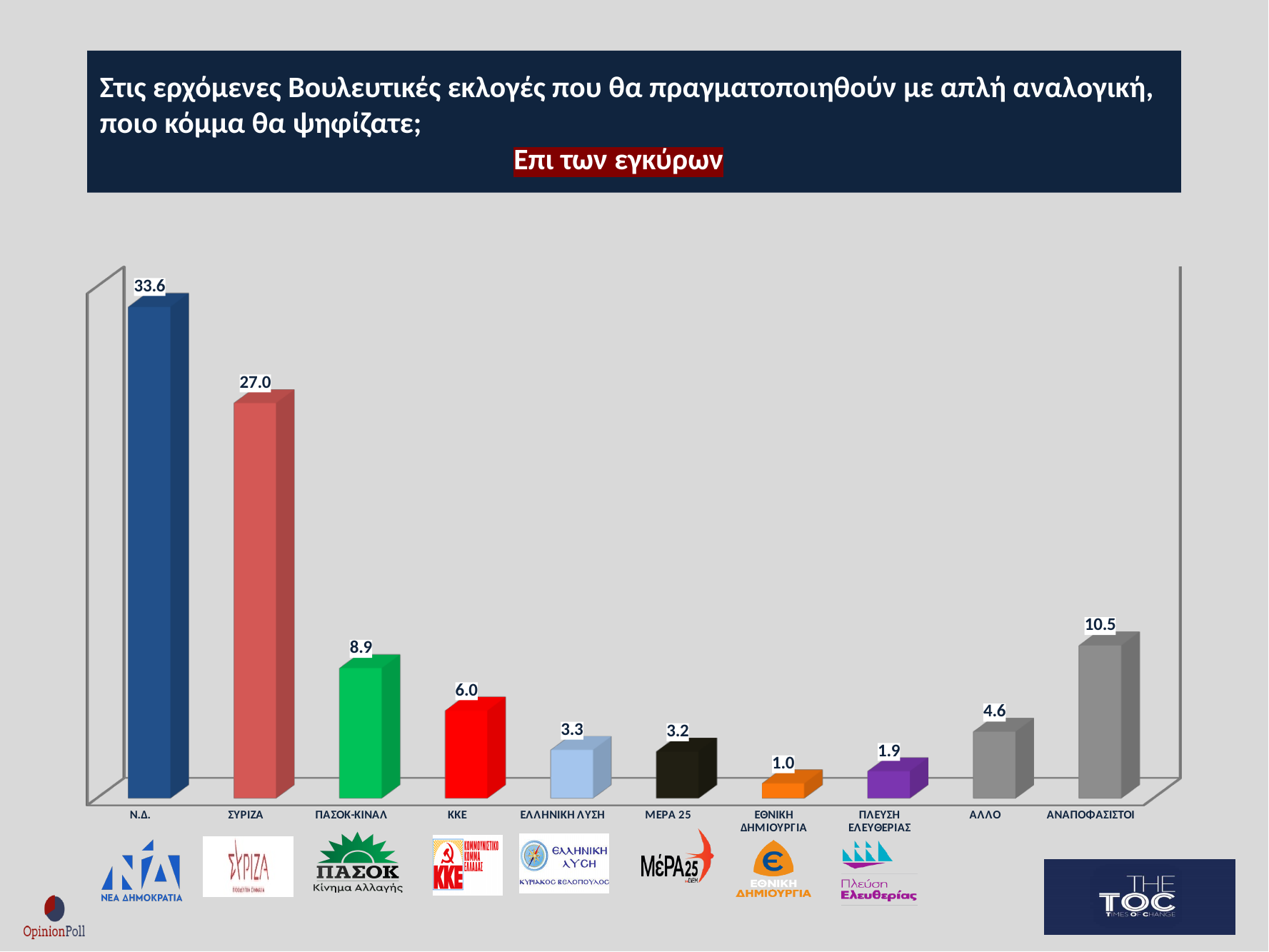
What is the value for ΑΝΑΠΟΦΑΣΙΣΤΟΙ? 10.5 What is the difference between the values for Ν.Δ. and ΣΥΡΙΖΑ? 6.6 What kind of chart is shown on the slide? bar chart What is the difference between the values for ΠΑΣΟΚ-ΚΙΝΑΛ and ΚΚΕ? 2.9 What colour is the bar for ΠΛΕΥΣΗ ΕΛΕΥΘΕΡΙΑΣ? purple What is the value for Ν.Δ.? 33.6 What is the value for ΠΑΣΟΚ-ΚΙΝΑΛ? 8.9 Which is larger, the value for ΚΚΕ or the value for ΑΛΛΟ? ΚΚΕ How many categories are shown on the chart? 10 What is the value for ΣΥΡΙΖΑ? 27.0 Which category has the lowest value? ΕΘΝΙΚΗ ΔΗΜΙΟΥΡΓΙΑ Which category has the highest value? Ν.Δ.